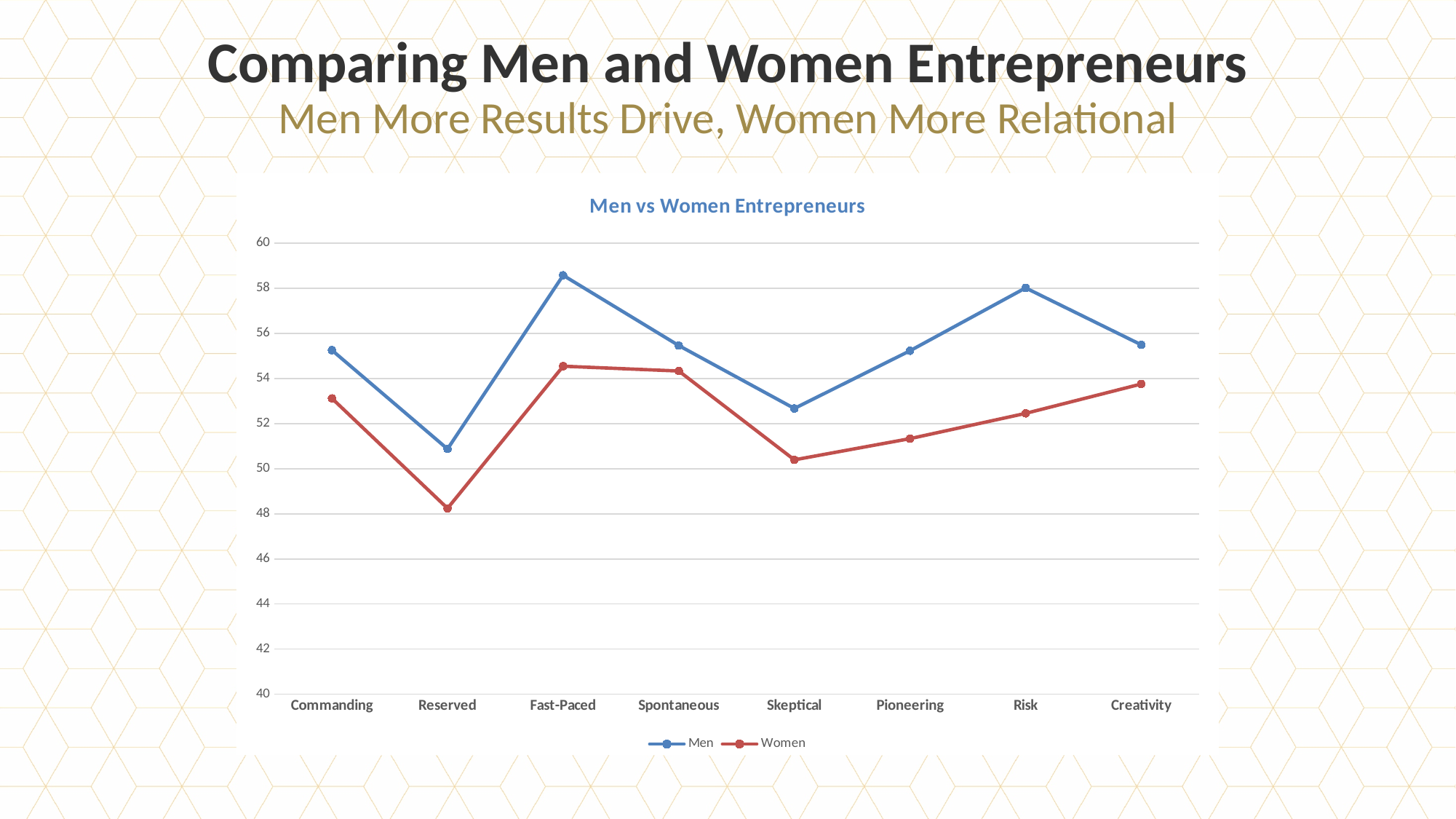
Is the value for Women at Reserved greater or less than 50? less What kind of chart is shown on the slide? line chart For which category is the Women series lowest? Reserved Does the Women series rise or fall from Skeptical to Creativity? rise For which category is the Men series highest? Fast-Paced At Pioneering, which series has the larger value, Men or Women? Men For which category is the Men series lowest? Reserved Is the value for Men at Fast-Paced greater or less than 58? greater Which series is drawn in red? Women How many series does the legend list? 2 How many categories are shown on the x axis? 8 What is the title of the chart? Men vs Women Entrepreneurs